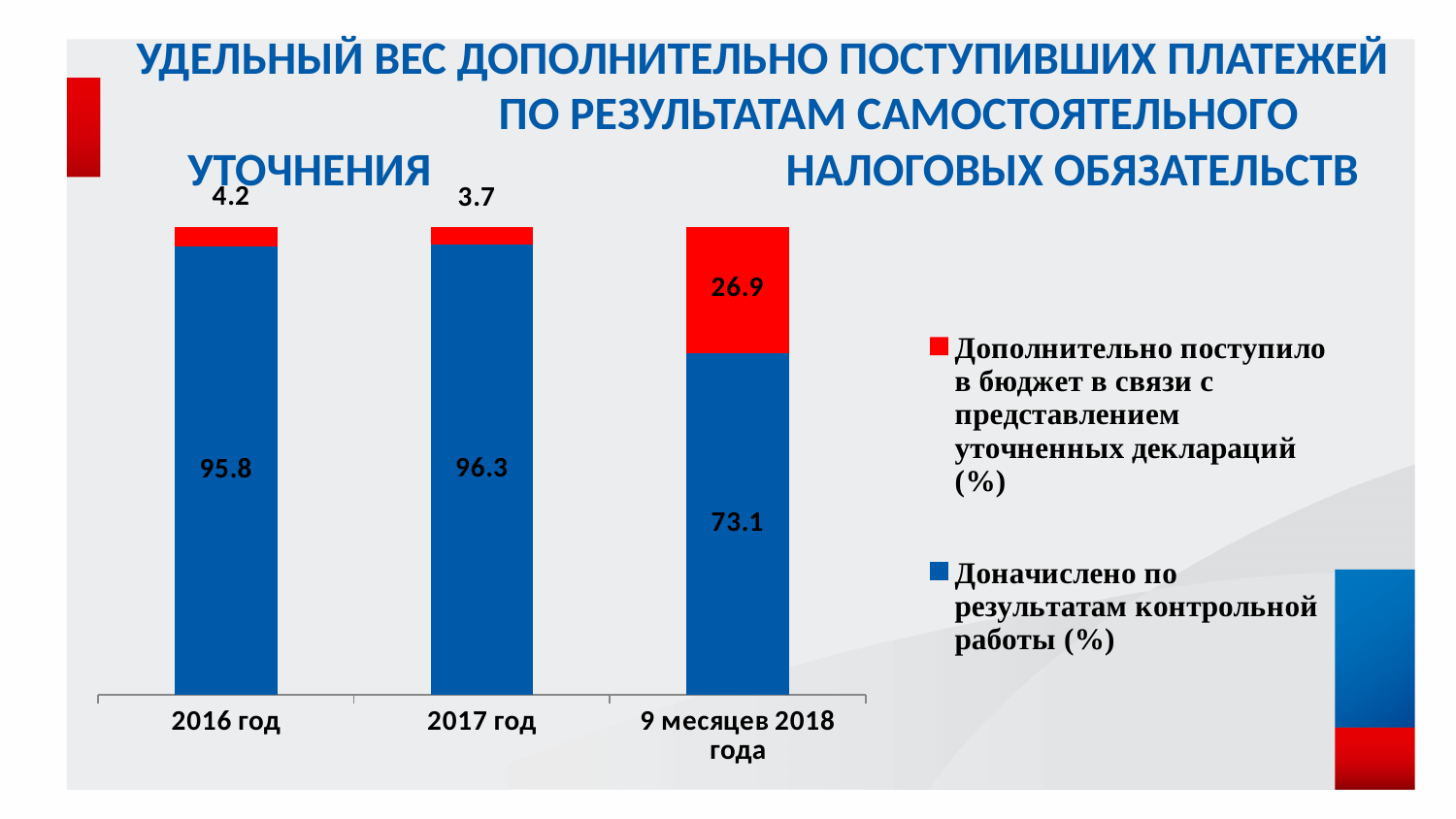
Which is larger: the 'Дополнительно поступило в бюджет' value for 2016 год or for 9 месяцев 2018 года? 9 месяцев 2018 года What is the value of 'Доначислено по результатам контрольной работы (%)' for 9 месяцев 2018 года? 73.1 Which category has the highest value for 'Доначислено по результатам контрольной работы (%)'? 2017 год What colour represents 'Доначислено по результатам контрольной работы (%)' in the chart? Blue How many series does the chart's legend list? 2 Which category has the lowest value for 'Дополнительно поступило в бюджет в связи с представлением уточненных деклараций (%)'? 2017 год What is the value of 'Дополнительно поступило в бюджет в связи с представлением уточненных деклараций (%)' for 9 месяцев 2018 года? 26.9 How many categories are shown on the x axis of the chart? 3 What is the value of 'Доначислено по результатам контрольной работы (%)' for 2016 год? 95.8 What is the value of 'Дополнительно поступило в бюджет в связи с представлением уточненных деклараций (%)' for 2017 год? 3.7 What is the difference between the 'Доначислено по результатам контрольной работы (%)' values for 2016 год and 9 месяцев 2018 года? 22.7 What kind of chart is shown on the slide? Stacked bar chart